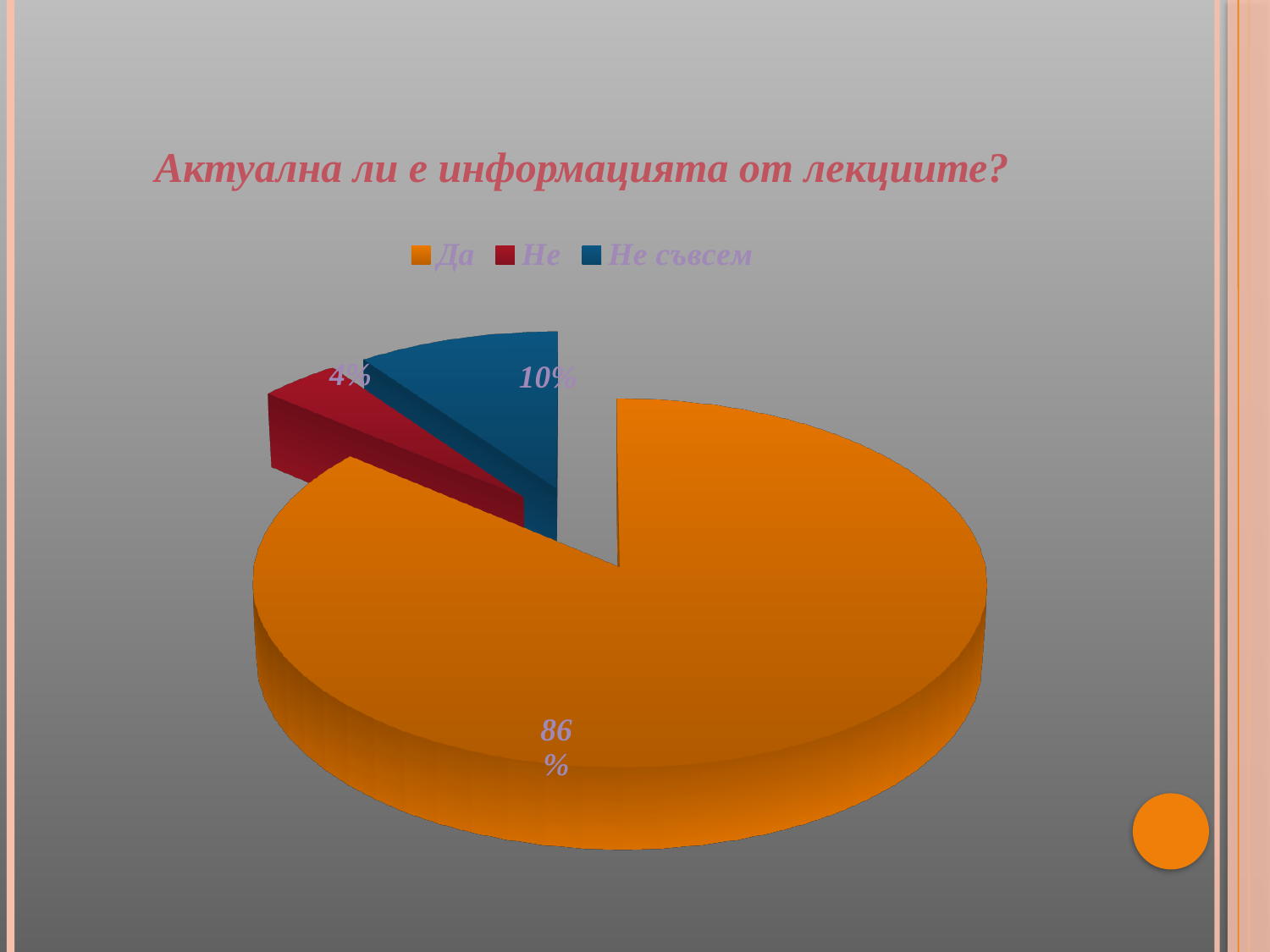
What share of the pie is labelled for "Не"? 4% What colour is the slice for "Не съвсем"? blue What share of the pie is labelled for "Не съвсем"? 10% What is the difference in percentage points between the "Да" slice and the "Не съвсем" slice? 76 Which is larger, the slice for "Не" or the slice for "Не съвсем"? Не съвсем Which category has the smallest slice of the pie? Не What share of the pie is labelled for "Да"? 86% How many categories does the legend list? 3 What is the title of the chart? Актуална ли е информацията от лекциите? Which category has the largest slice of the pie? Да What kind of chart is shown on the slide? pie chart What is the difference in percentage points between the "Не съвсем" slice and the "Не" slice? 6